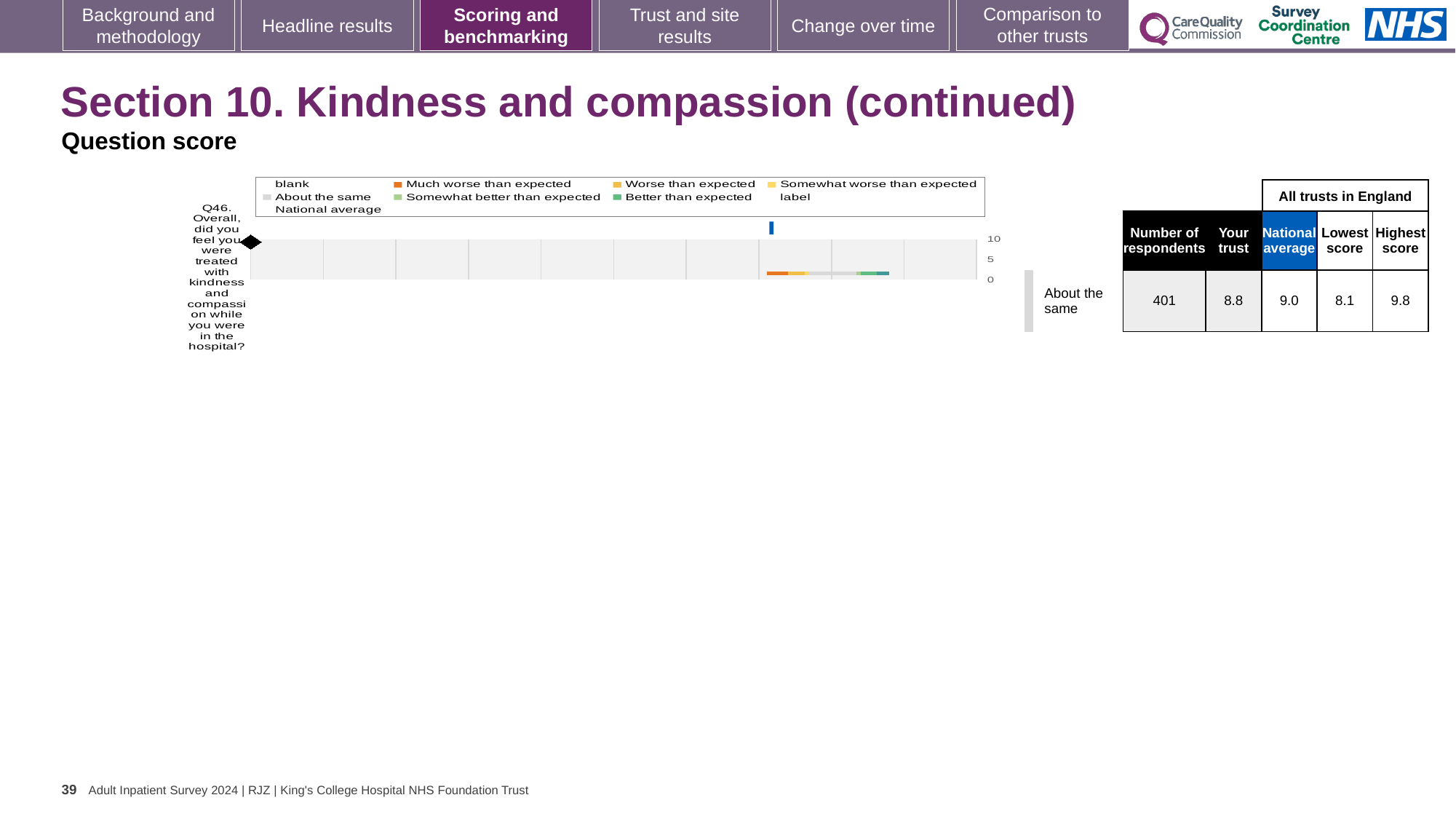
What is the highest tick value shown on the chart's axis? 10 What kind of chart is shown on the slide? bar chart How many questions (categories) are plotted in the chart? 1 What is the lowest score among all trusts in England for Q46? 8.1 What is the number of respondents for Q46? 401 How many entries does the chart legend list? 9 Which is larger for Q46, the 'Your trust' score or the national average? national average What is the highest score among all trusts in England for Q46? 9.8 Which question is plotted in the chart? Q46. Overall, did you feel you were treated with kindness and compassion while you were in the hospital? What is the national average score for Q46? 9.0 What is the 'Your trust' score for Q46? 8.8 What benchmark category is given for Q46 next to the chart? About the same